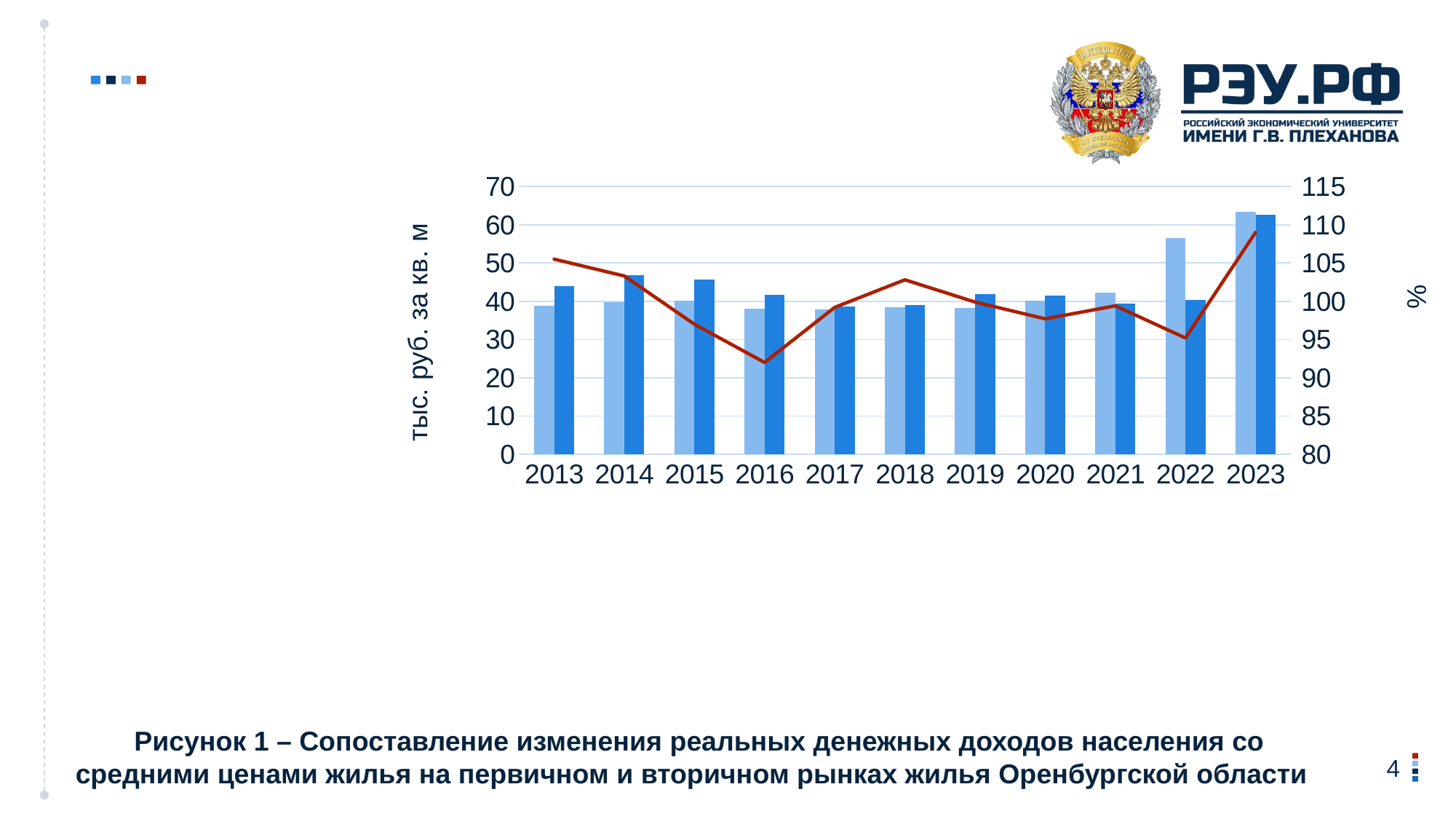
What is the label of the left vertical axis of the chart? тыс. руб. за кв. м In which year does the red line reach its highest point? 2023 What kind of chart is shown on the slide? Combination bar and line chart In 2022, which bar is taller, the light blue bar or the dark blue bar? The light blue bar Is the value of the red line for 2016 greater or less than 95? less In which year does the red line reach its lowest point? 2016 What is the label of the right vertical axis of the chart? % In which year is the light blue bar the highest? 2023 How many years are shown on the x axis of the chart? 11 Do the light blue bars rise or fall from 2021 to 2023? Rise Is the value of the dark blue bar for 2017 greater or less than 40? less Is the value of the light blue bar for 2023 greater or less than 60? greater